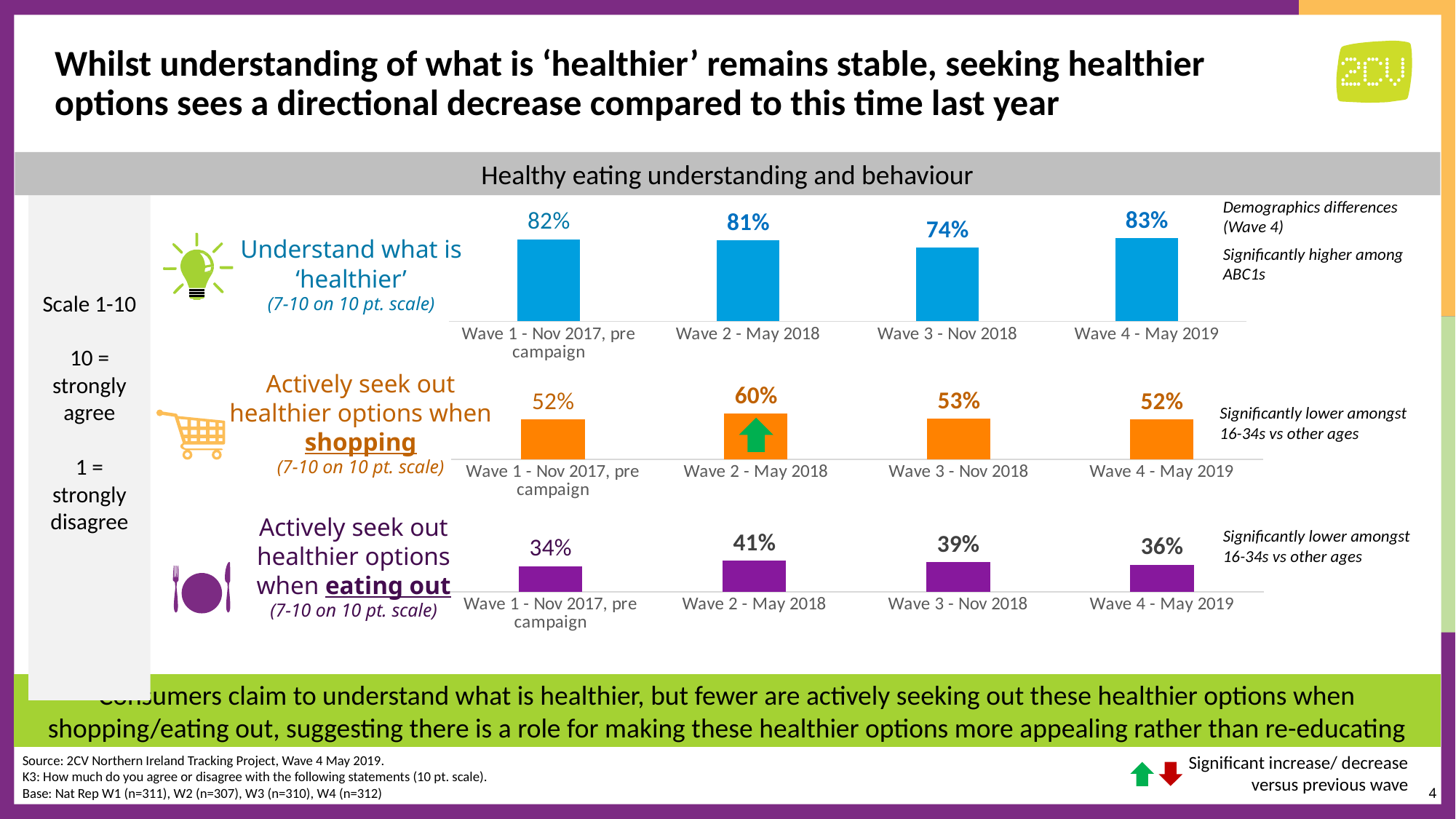
In the 'Understand what is healthier' chart, what is the value for Wave 4 - May 2019? 83% In the 'Actively seek out healthier options when shopping' chart, which wave has the highest value? Wave 2 - May 2018 What type of chart is used for 'Understand what is healthier'? bar chart In the 'Actively seek out healthier options when shopping' chart, is the value for Wave 3 - Nov 2018 larger or smaller than the value for Wave 2 - May 2018? smaller In the 'Understand what is healthier' chart, which wave has the lowest value? Wave 3 - Nov 2018 How many waves are shown in the 'Actively seek out healthier options when eating out' chart? 4 In the 'Understand what is healthier' chart, what is the difference between Wave 4 - May 2019 and Wave 3 - Nov 2018? 9% In the 'Actively seek out healthier options when shopping' chart, what is the value for Wave 2 - May 2018? 60% In the 'Actively seek out healthier options when eating out' chart, what is the value for Wave 1 - Nov 2017, pre campaign? 34% In the 'Actively seek out healthier options when eating out' chart, what is the difference between Wave 2 - May 2018 and Wave 4 - May 2019? 5% What colour are the bars in the 'Actively seek out healthier options when shopping' chart? orange In the 'Actively seek out healthier options when eating out' chart, which wave has the lowest value? Wave 1 - Nov 2017, pre campaign